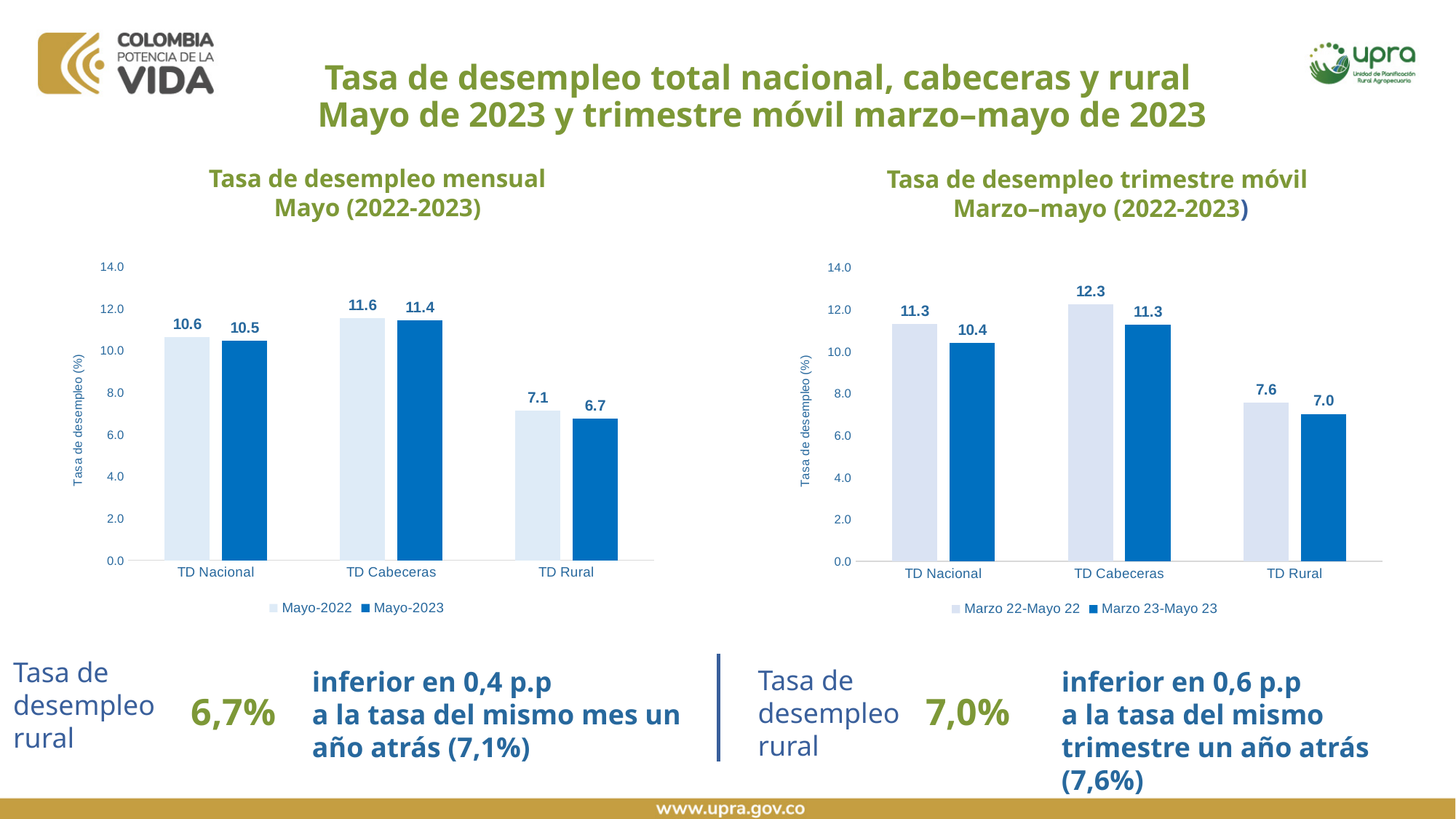
In the left chart (Tasa de desempleo mensual Mayo), what is the difference between the TD Rural values for Mayo-2022 and Mayo-2023? 0.4 In the right chart (Tasa de desempleo trimestre móvil), what is the difference between the TD Cabeceras values for Marzo 22-Mayo 22 and Marzo 23-Mayo 23? 1.0 In the right chart (Tasa de desempleo trimestre móvil), which category has the highest value for Marzo 22-Mayo 22? TD Cabeceras In the left chart (Tasa de desempleo mensual Mayo), which is larger: TD Nacional in Mayo-2023 or TD Cabeceras in Mayo-2023? TD Cabeceras in Mayo-2023 How many categories are shown on the x axis of the left chart (Tasa de desempleo mensual Mayo)? 3 How many series does the legend of the right chart (Tasa de desempleo trimestre móvil) list? 2 What kind of chart is the left chart (Tasa de desempleo mensual Mayo)? Bar chart In the right chart (Tasa de desempleo trimestre móvil), is the value for TD Rural in Marzo 23-Mayo 23 greater or less than 8.0? less In the left chart (Tasa de desempleo mensual Mayo), what is the value for TD Rural in Mayo-2022? 7.1 In the left chart (Tasa de desempleo mensual Mayo), which category has the lowest value for Mayo-2023? TD Rural In the right chart (Tasa de desempleo trimestre móvil), what is the value for TD Nacional in Marzo 23-Mayo 23? 10.4 In the left chart (Tasa de desempleo mensual Mayo), what is the value for TD Cabeceras in Mayo-2023? 11.4